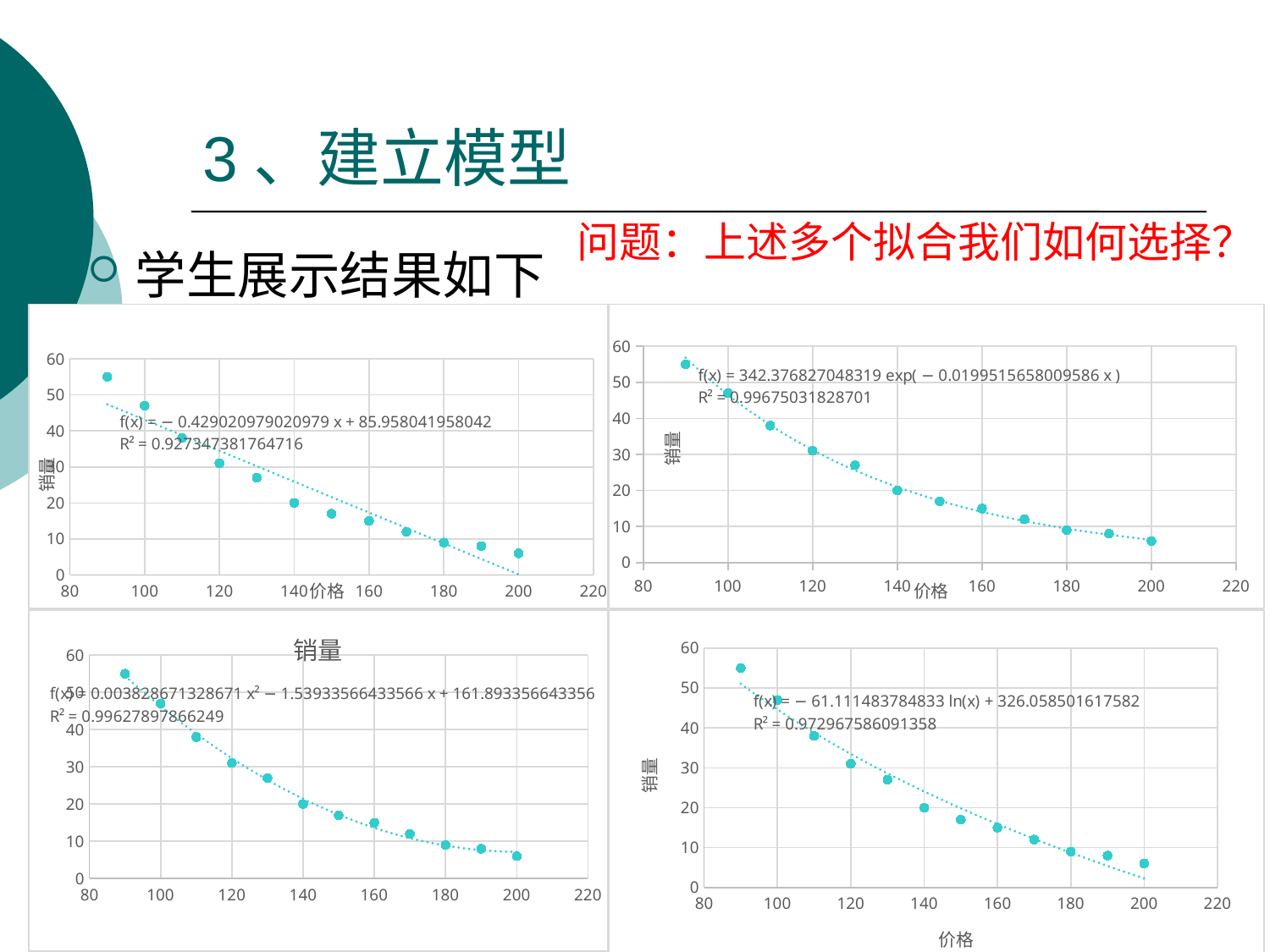
In the bottom-left chart, at which 价格 value is 销量 lowest? 200 In the bottom-right chart, is the 销量 value at 价格 200 greater or less than 10? less In the top-right chart, do the plotted values rise or fall as 价格 increases? fall What kind of chart is the top-left chart on the slide? scatter chart What R² value is printed on the top-left chart? 0.927347381764716 What R² value is printed on the top-right chart? 0.99675031828701 In the bottom-left chart, which has the larger 销量 value: 价格 100 or 价格 180? 价格 100 How many data points are plotted in the bottom-right chart? 12 What is the title of the bottom-left chart? 销量 In the top-left chart, is the 销量 value at 价格 160 greater or less than 20? less In the top-left chart, at which 价格 value is 销量 highest? 90 In the top-right chart, is the 销量 value at 价格 90 greater or less than 50? greater